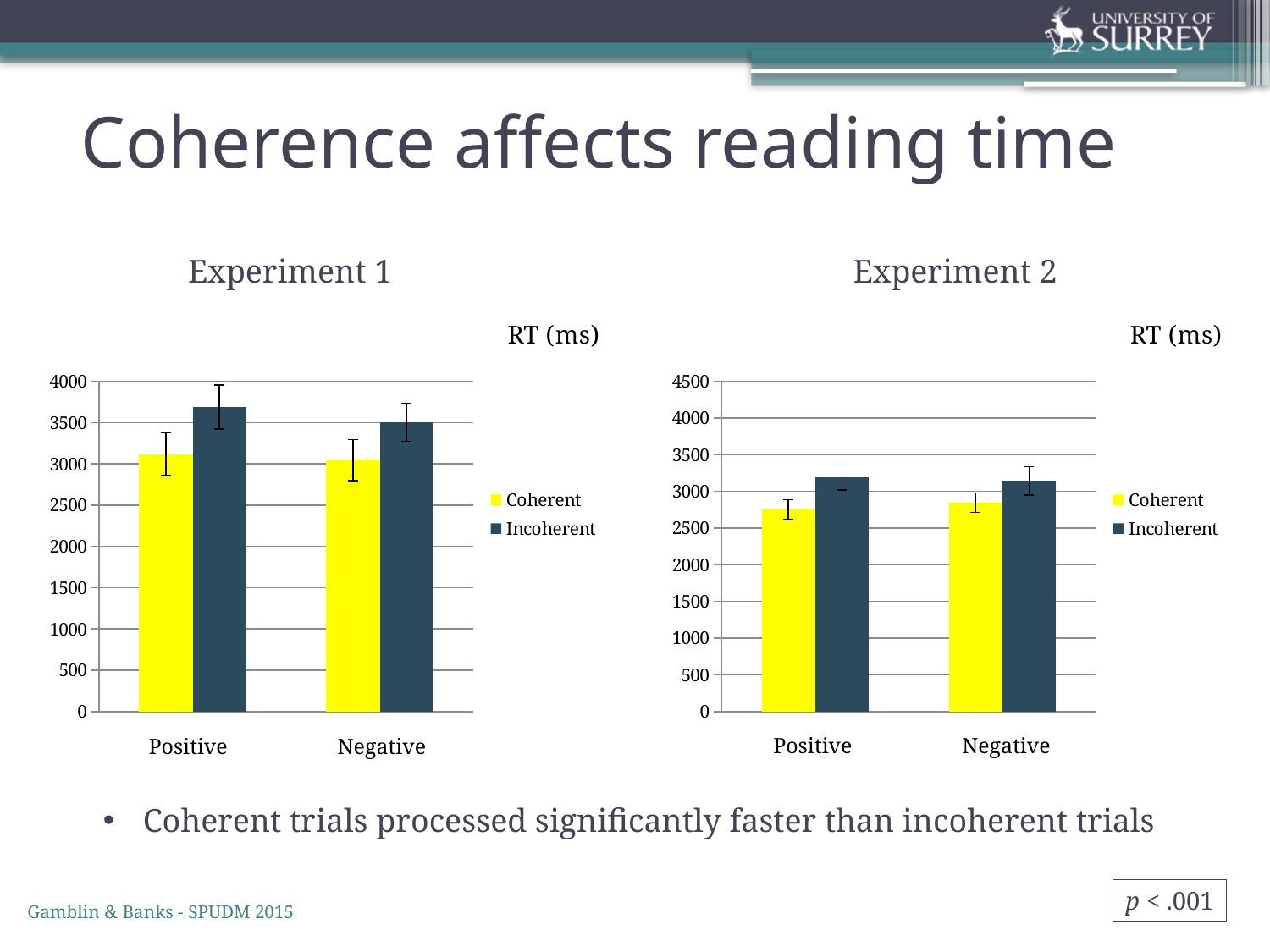
Which colour represents the Coherent series in the Experiment 1 chart? Yellow In the Experiment 1 chart, for the Positive category, which is larger: Coherent or Incoherent? Incoherent What kind of chart is used for Experiment 1? Bar chart What is the y-axis label shown above the Experiment 2 chart? RT (ms) In the Experiment 1 chart, is the Coherent value for Negative greater or less than 3500? less In the Experiment 2 chart, for the Negative category, which is larger: Coherent or Incoherent? Incoherent In the Experiment 1 chart, which bar is the tallest? Incoherent, Positive In the Experiment 2 chart, is the Coherent value for Positive greater or less than 3000? less How many series does the legend of the Experiment 2 chart list? 2 How many categories are shown on the x axis of the Experiment 1 chart? 2 In the Experiment 1 chart, is the Incoherent value for Positive greater or less than 3500? greater